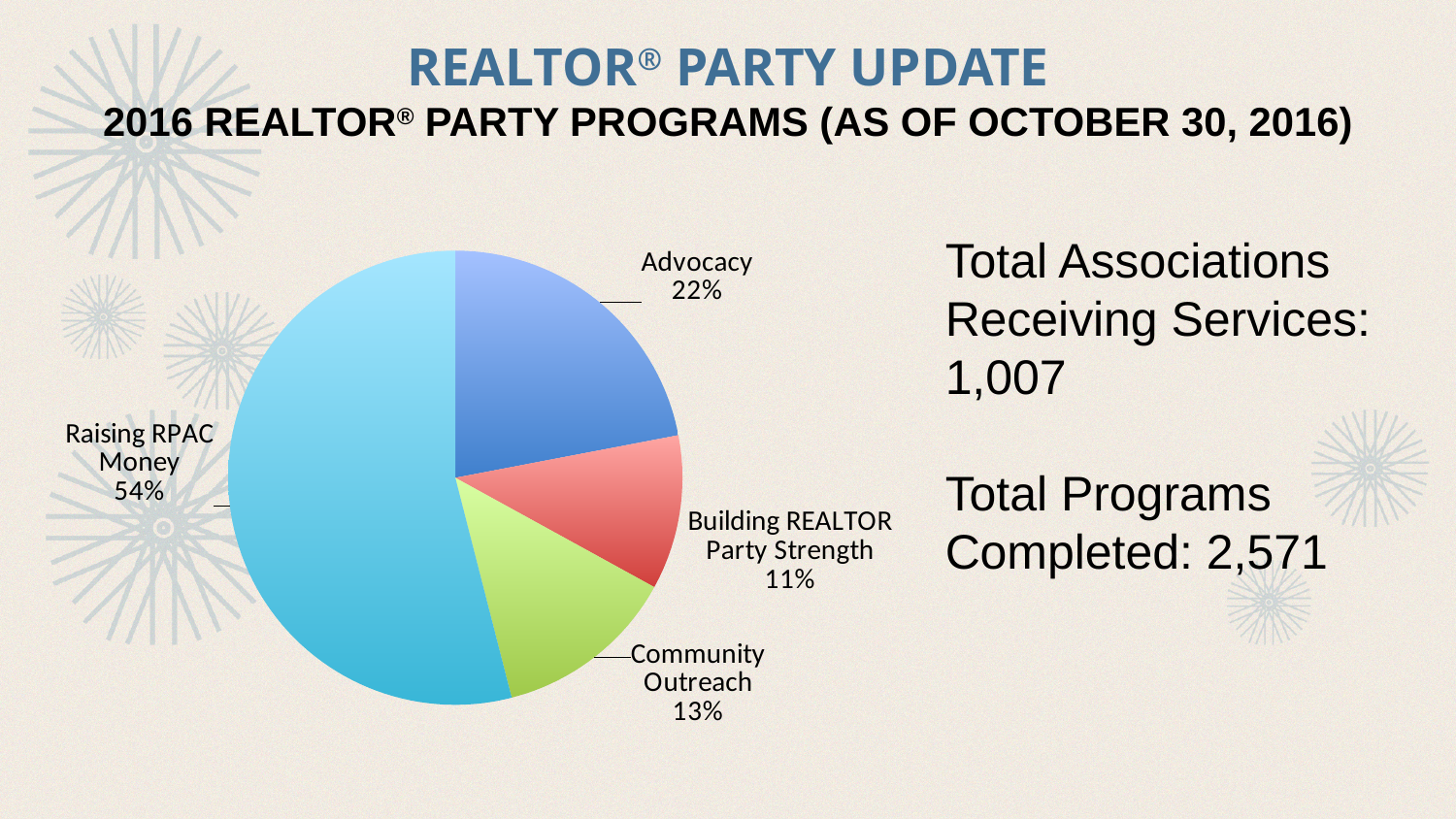
What percentage is shown for Building REALTOR Party Strength? 11% How many categories are shown in the pie chart? 4 What percentage is shown for Community Outreach? 13% Which category has the largest slice of the pie? Raising RPAC Money What share of the pie does Raising RPAC Money represent? 54% What colour is the Raising RPAC Money slice? Light blue Which category has the smallest slice of the pie? Building REALTOR Party Strength Which is larger, Community Outreach or Building REALTOR Party Strength? Community Outreach What is the difference in percentage points between Raising RPAC Money and Advocacy? 32 What kind of chart is shown on the slide? Pie chart What is the difference in percentage points between Community Outreach and Building REALTOR Party Strength? 2 What percentage is shown for Advocacy? 22%